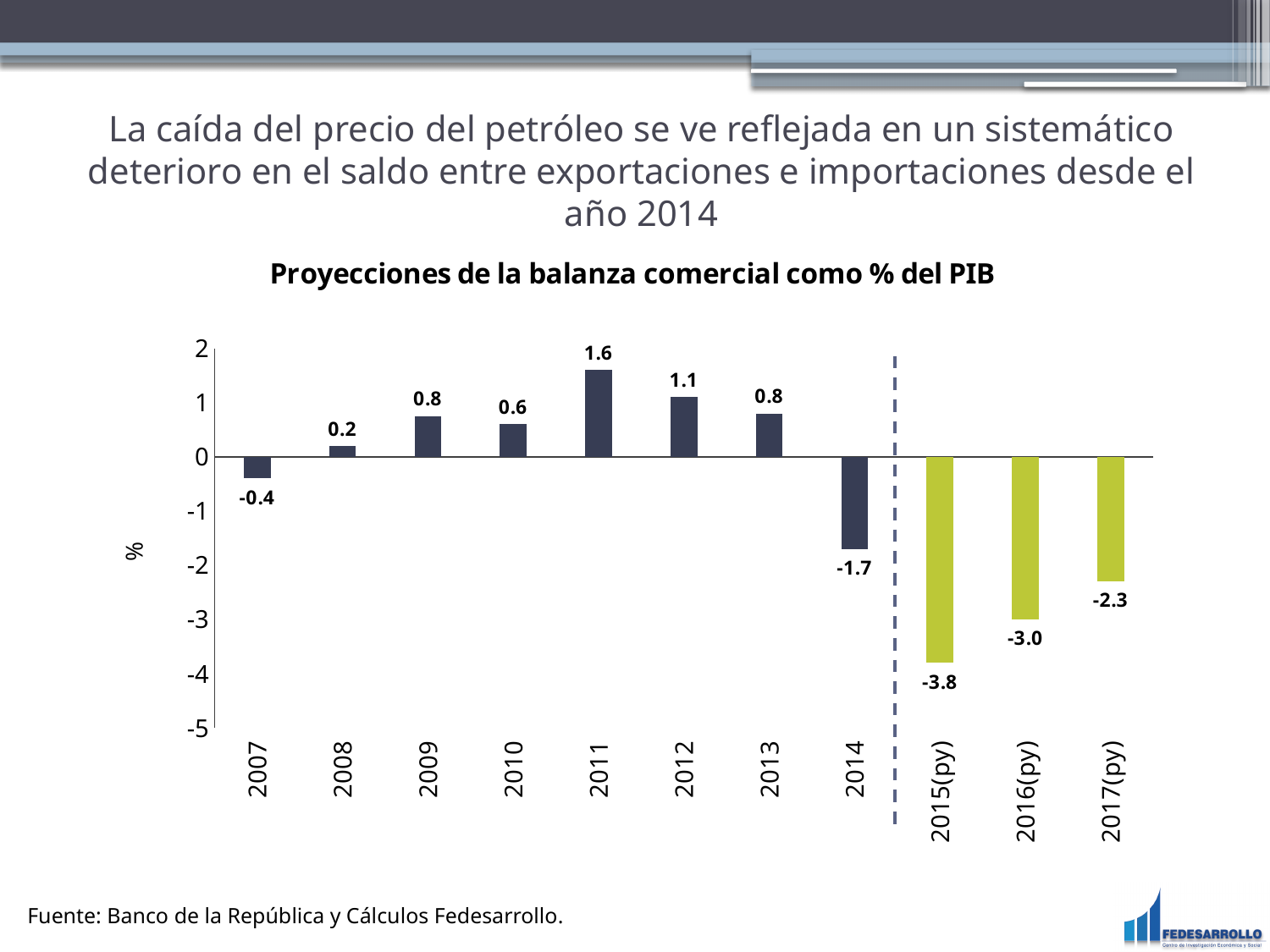
Which year has the highest value? 2011 Do the values rise or fall from 2013 to 2015(py)? Fall Which is larger, the value for 2009 or the value for 2010? 2009 What is the value for 2011? 1.6 What is the difference between the values for 2016(py) and 2017(py)? 0.7 What is the value for 2015(py)? -3.8 How many years are shown on the x axis? 11 Which year has the lowest value? 2015(py) What kind of chart is this? Bar chart What is the title of the chart? Proyecciones de la balanza comercial como % del PIB What is the difference between the values for 2011 and 2012? 0.5 What is the value for 2007? -0.4